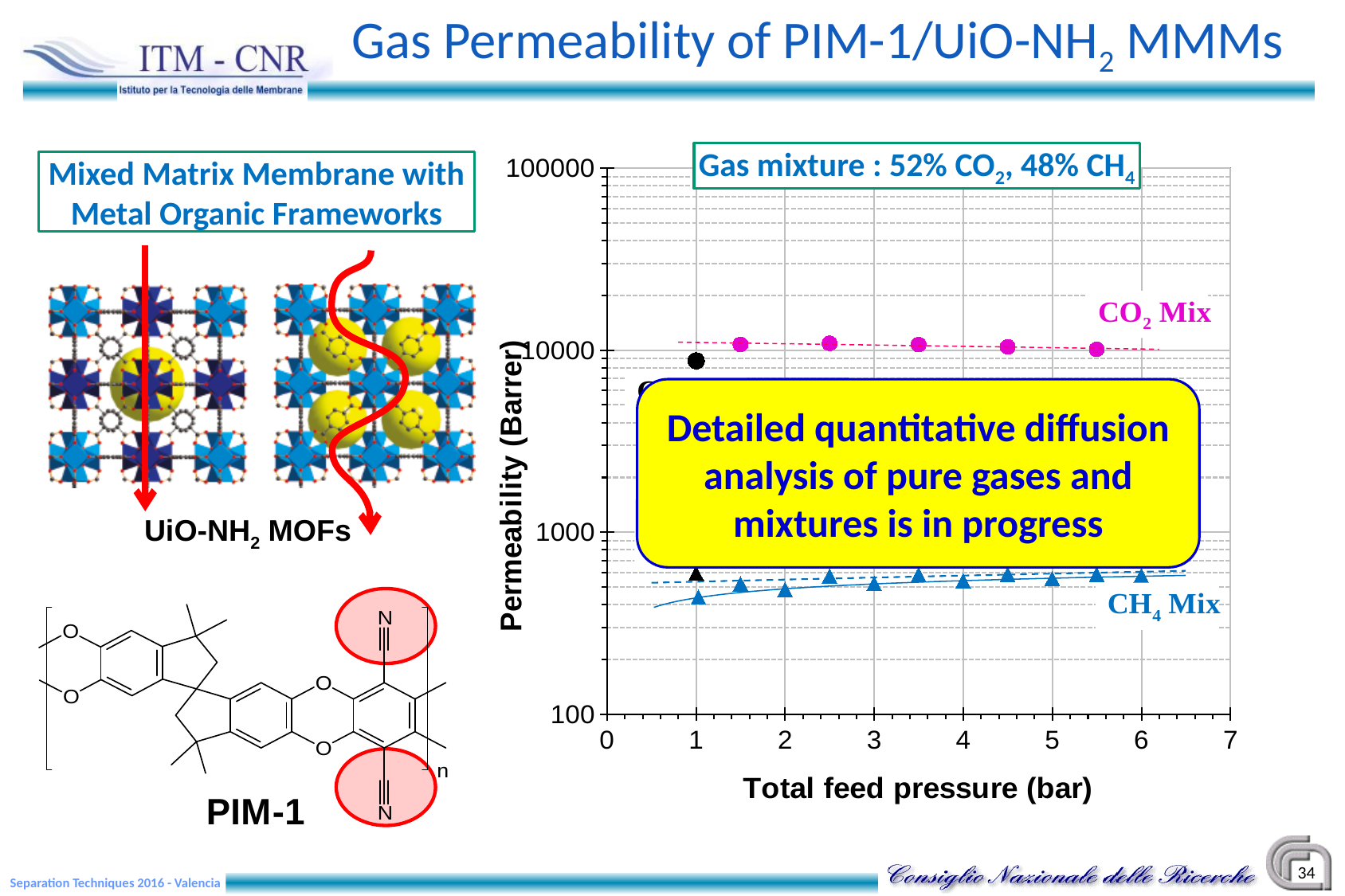
Is the CH4 Mix permeability at 3 bar greater or less than 1000 Barrer? less What is the title of the x axis of the chart? Total feed pressure (bar) Is the CO2 Mix permeability at 2.5 bar greater or less than 1000 Barrer? greater Which series has the higher permeability at 3.5 bar, CO2 Mix or CH4 Mix? CO2 Mix Which series on the chart has the lowest permeability values overall? CH4 Mix How many CH4 Mix data points (blue triangles) are plotted on the chart? 11 Is the CH4 Mix permeability at 6 bar greater or less than 100 Barrer? greater Does the CH4 Mix permeability rise or fall as total feed pressure increases? rise What kind of chart is shown on the slide? Scatter chart What is the title of the y axis of the chart? Permeability (Barrer) How many CO2 Mix data points (magenta circles) are plotted on the chart? 5